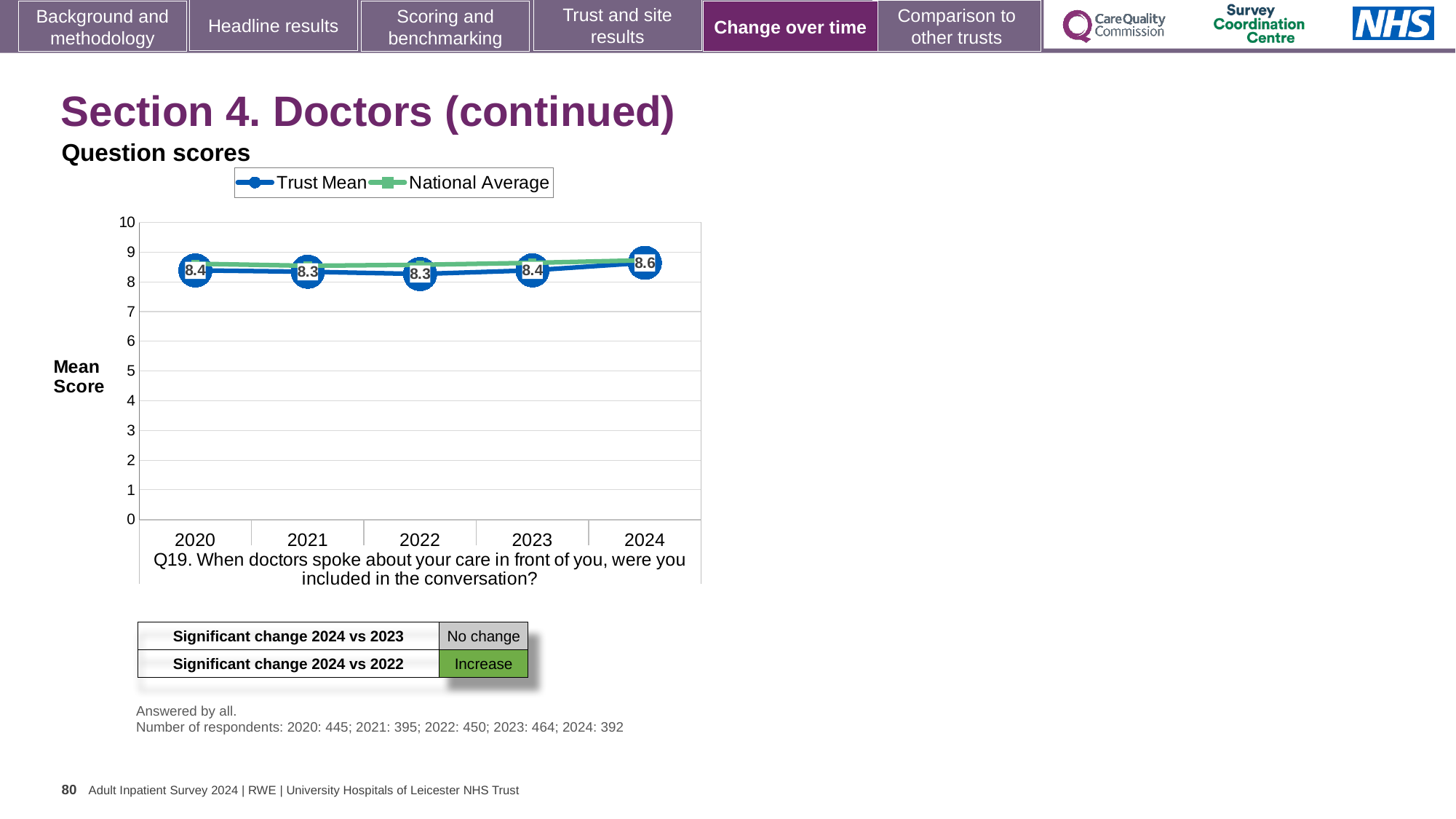
What is the Trust Mean score for 2020? 8.4 Is the National Average value for 2020 greater or less than 8? greater What is the difference between the Trust Mean scores for 2024 and 2022? 0.3 What is the Trust Mean score for 2022? 8.3 In which year is the Trust Mean score highest? 2024 How many series does the legend list? 2 Does the Trust Mean score rise or fall from 2022 to 2024? Rise What is the label on the y axis of the chart? Mean Score How many years are plotted on the x axis? 5 What is the Trust Mean score for 2024? 8.6 Which year has the larger Trust Mean score, 2020 or 2024? 2024 What kind of chart is shown on the slide? Line chart